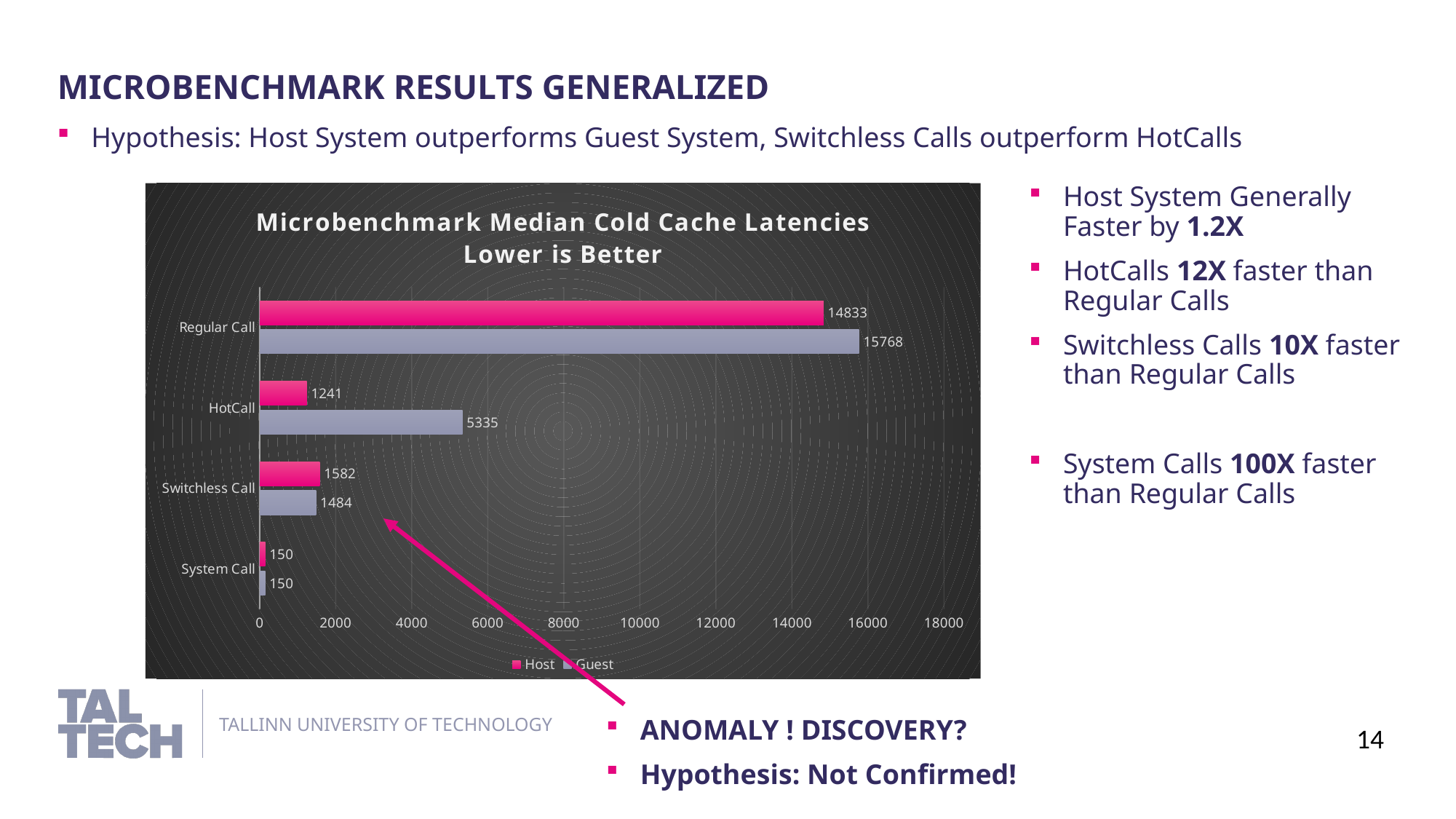
Which is larger for Switchless Call, the Host value or the Guest value? Host What is the difference between the Guest and Host values for Regular Call? 935 How many series does the legend list? 2 What is the Host value for System Call? 150 What is the Guest value for HotCall? 5335 What is the Host value for Regular Call? 14833 How many categories are shown on the chart? 4 What kind of chart is shown on the slide? Bar chart What is the Guest value for Switchless Call? 1484 Which category has the lowest Host value? System Call What is the difference between the Guest and Host values for HotCall? 4094 Which category has the highest Guest value? Regular Call